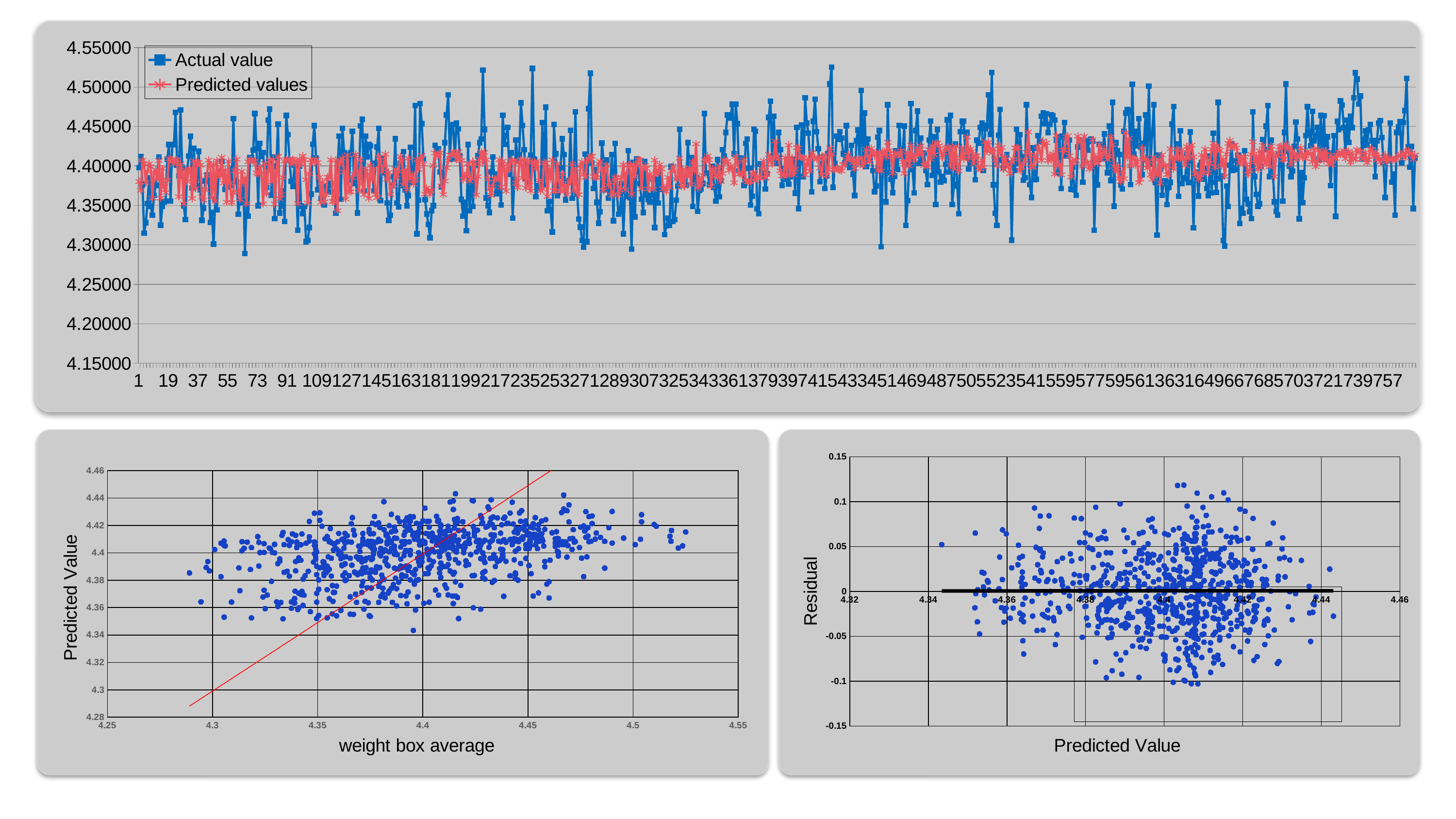
In the top chart, do the Predicted values generally rise or fall from left to right along the x axis? rise What are the two series named in the legend of the top chart? Actual value, Predicted values How many series does the legend of the top chart list? 2 What kind of chart is the bottom-left chart on the slide? scatter chart In the bottom-left chart, is the Predicted Value for the point with the largest weight box average greater or less than 4.38? greater In the top chart, is the Actual value at point 1 greater or less than 4.35000? greater What kind of chart is the top chart on the slide? line chart In the bottom-right chart, is the Residual for the leftmost point (near 4.34) greater or less than 0? greater What kind of chart is the bottom-right chart on the slide? scatter chart What is the x-axis label of the bottom-left chart? weight box average